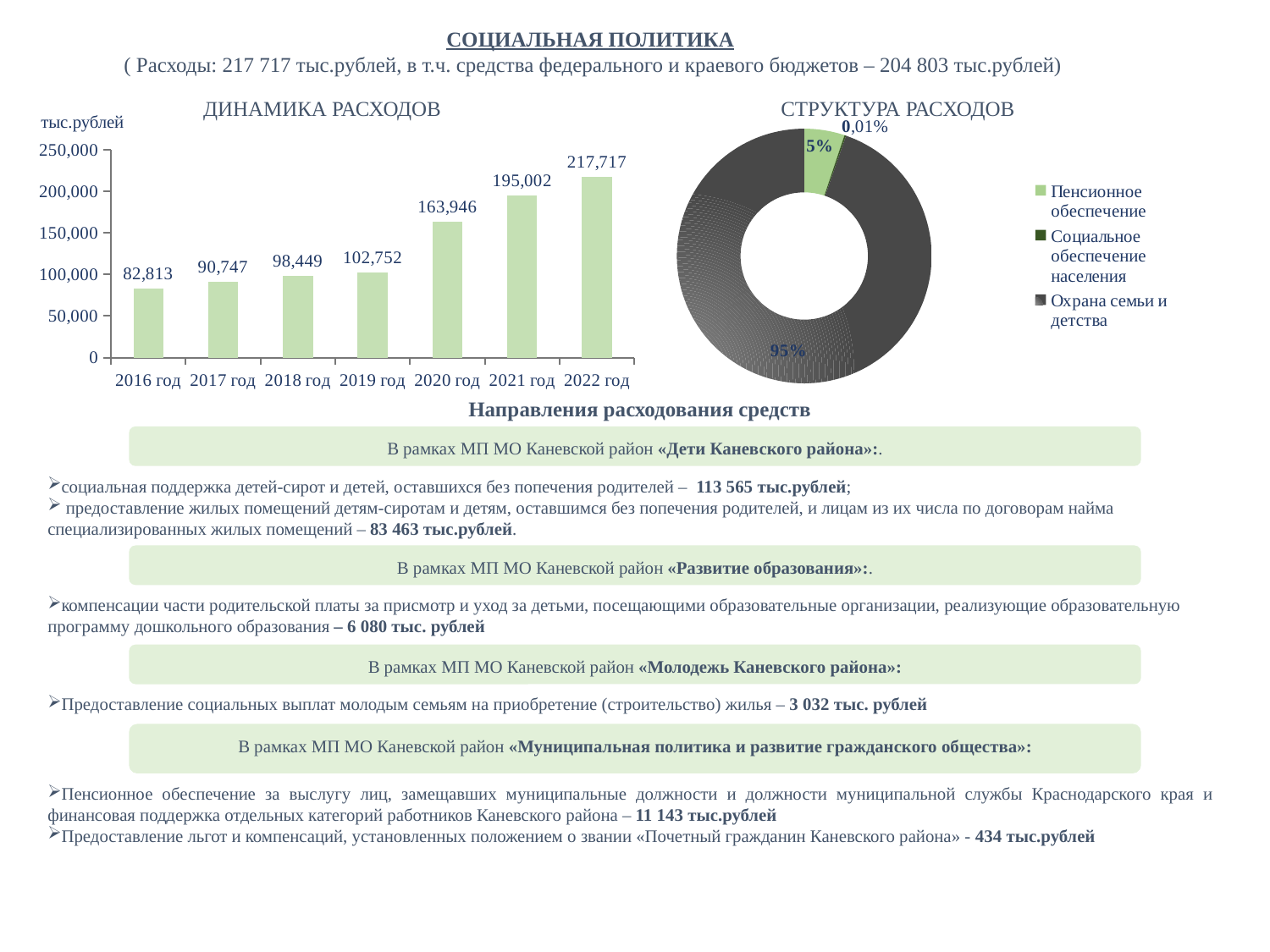
In the 'СТРУКТУРА РАСХОДОВ' chart, what share does 'Охрана семьи и детства' have? 95% In the 'ДИНАМИКА РАСХОДОВ' chart, which is larger: the value for 2018 год or 2019 год? 2019 год What kind of chart is 'ДИНАМИКА РАСХОДОВ'? bar chart In the 'ДИНАМИКА РАСХОДОВ' chart, which year has the highest value? 2022 год In the 'ДИНАМИКА РАСХОДОВ' chart, which year has the lowest value? 2016 год In the 'ДИНАМИКА РАСХОДОВ' chart, what is the value for 2020 год? 163,946 How many years are shown in the 'ДИНАМИКА РАСХОДОВ' chart? 7 How many entries does the legend of the 'СТРУКТУРА РАСХОДОВ' chart list? 3 In the 'ДИНАМИКА РАСХОДОВ' chart, what is the difference between the values for 2020 год and 2019 год? 61,194 In the 'ДИНАМИКА РАСХОДОВ' chart, do the values rise or fall from 2016 год to 2022 год? rise In the 'ДИНАМИКА РАСХОДОВ' chart, what is the difference between the values for 2022 год and 2021 год? 22,715 In the 'ДИНАМИКА РАСХОДОВ' chart, what is the value for 2017 год? 90,747